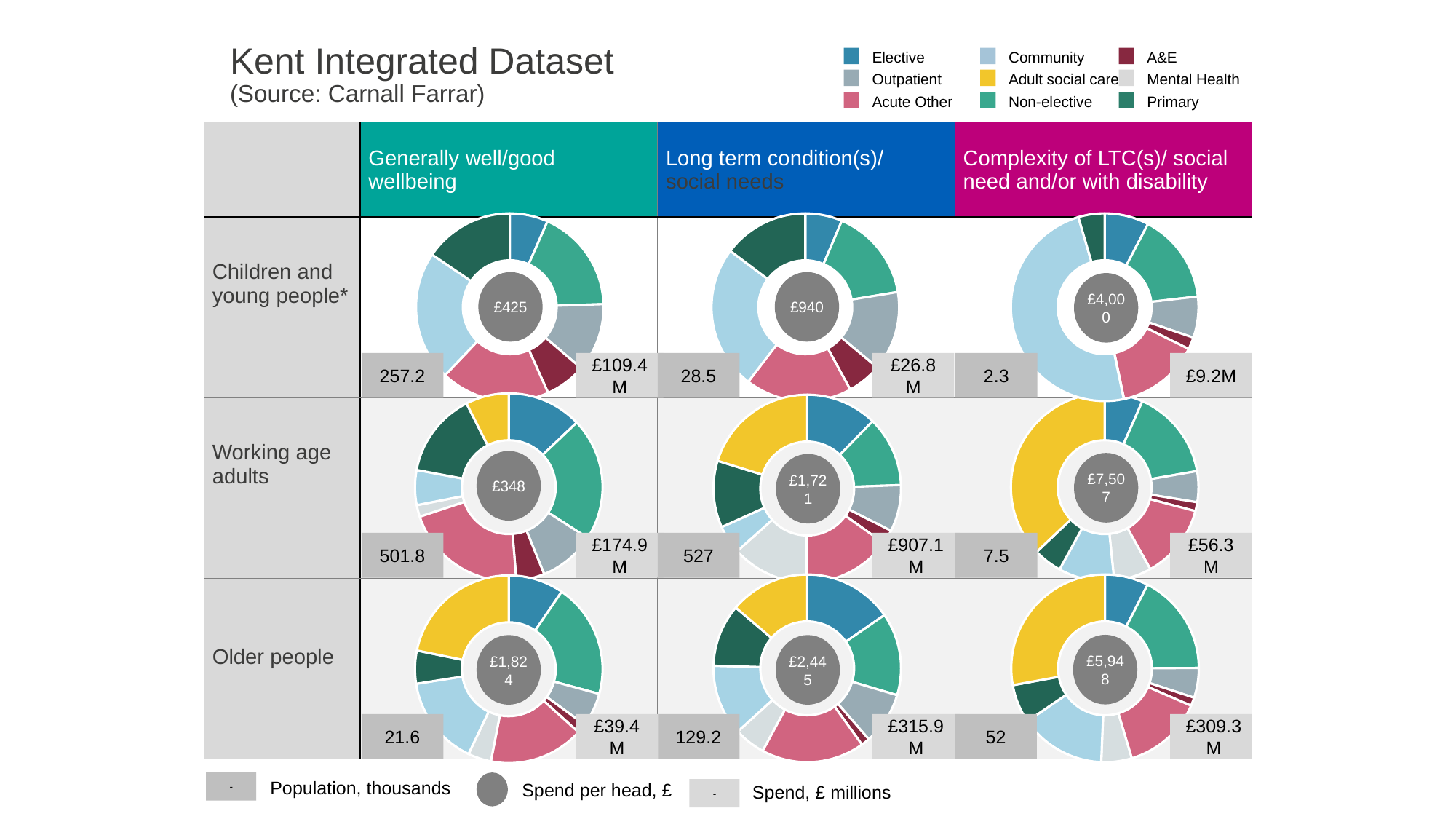
For the Older people / Complexity of LTC(s) chart, what is the spend in £ millions shown? £309.3M Which has the larger spend in £ millions: Working age adults / Long term condition(s) or Older people / Long term condition(s)? Working age adults / Long term condition(s) What type of chart is used in each cell of the grid? Donut (pie) chart Across all nine charts, which one shows the lowest population in thousands? Children and young people / Complexity of LTC(s) (2.3) For the Working age adults / Long term condition(s) chart, what is the population in thousands shown in the grey box? 527 How many donut charts are shown on the slide? 9 Within the Generally well/good wellbeing column, which row has the highest spend per head? Older people What is the difference in spend per head between the Older people / Long term condition(s) chart and the Older people / Generally well chart? £621 In the donut chart for Working age adults under Complexity of LTC(s)/ social need and/or with disability, what is the spend per head shown in the centre? £7,507 In the Children and young people / Complexity of LTC(s) donut chart, which category has the largest slice? Community In the donut chart for Children and young people under Generally well/good wellbeing, what is the spend per head shown in the centre? £425 How many categories does the legend at the top of the slide list? 9